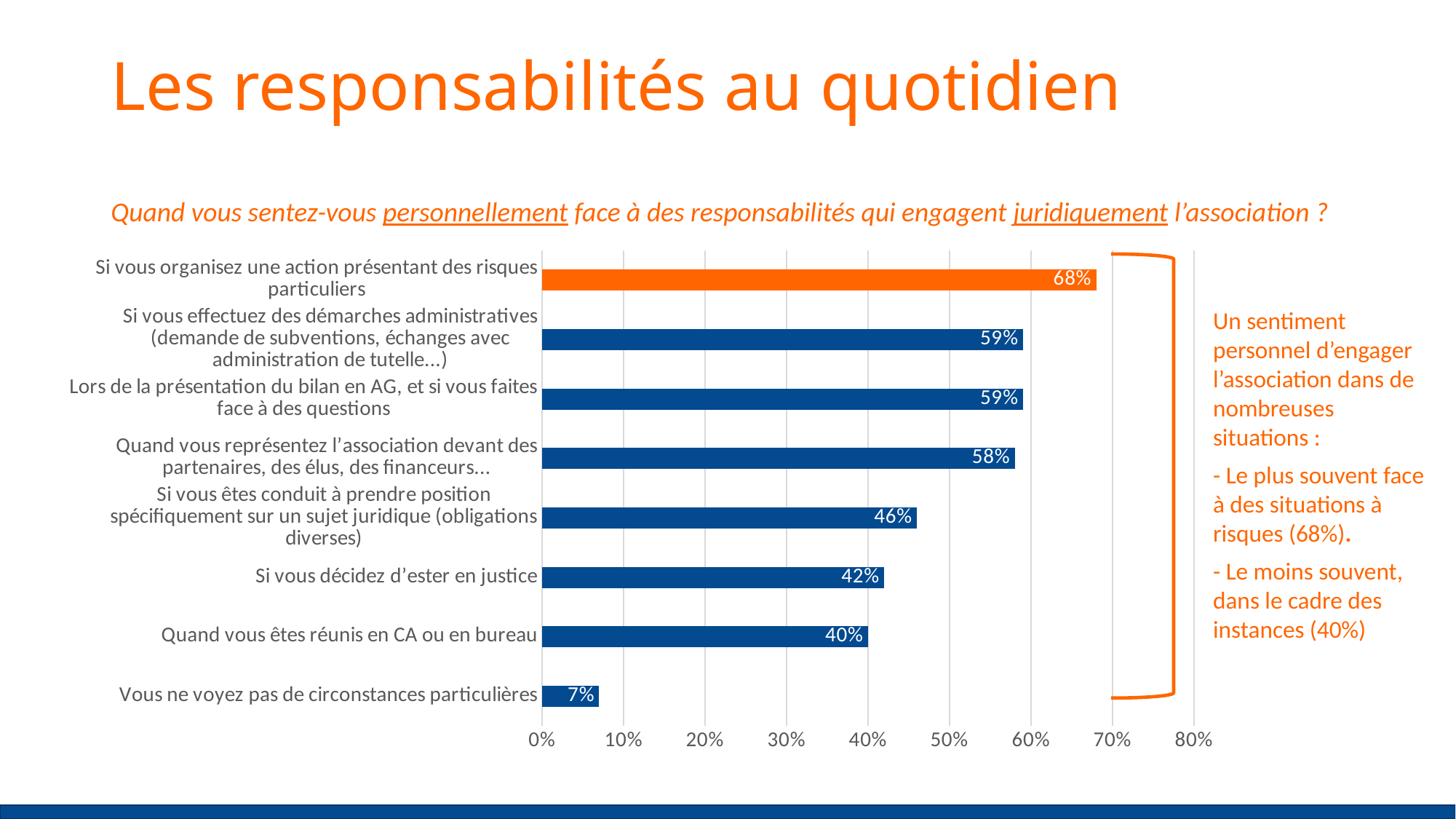
What kind of chart is shown on the slide? bar chart What is the value for "Vous ne voyez pas de circonstances particulières"? 7% Which bar is coloured orange rather than blue? Si vous organisez une action présentant des risques particuliers What is the value for "Quand vous êtes réunis en CA ou en bureau"? 40% Which is larger: the value for "Si vous êtes conduit à prendre position spécifiquement sur un sujet juridique (obligations diverses)" or the value for "Si vous décidez d'ester en justice"? Si vous êtes conduit à prendre position spécifiquement sur un sujet juridique (obligations diverses) What is the value for "Si vous décidez d'ester en justice"? 42% How many categories are shown in the chart? 8 Which category has the lowest value? Vous ne voyez pas de circonstances particulières What is the value for "Si vous organisez une action présentant des risques particuliers"? 68% Is the value for "Quand vous représentez l'association devant des partenaires, des élus, des financeurs…" greater or less than 50%? greater Which category has the highest value? Si vous organisez une action présentant des risques particuliers What is the difference between the value for "Si vous organisez une action présentant des risques particuliers" and the value for "Quand vous êtes réunis en CA ou en bureau"? 28%